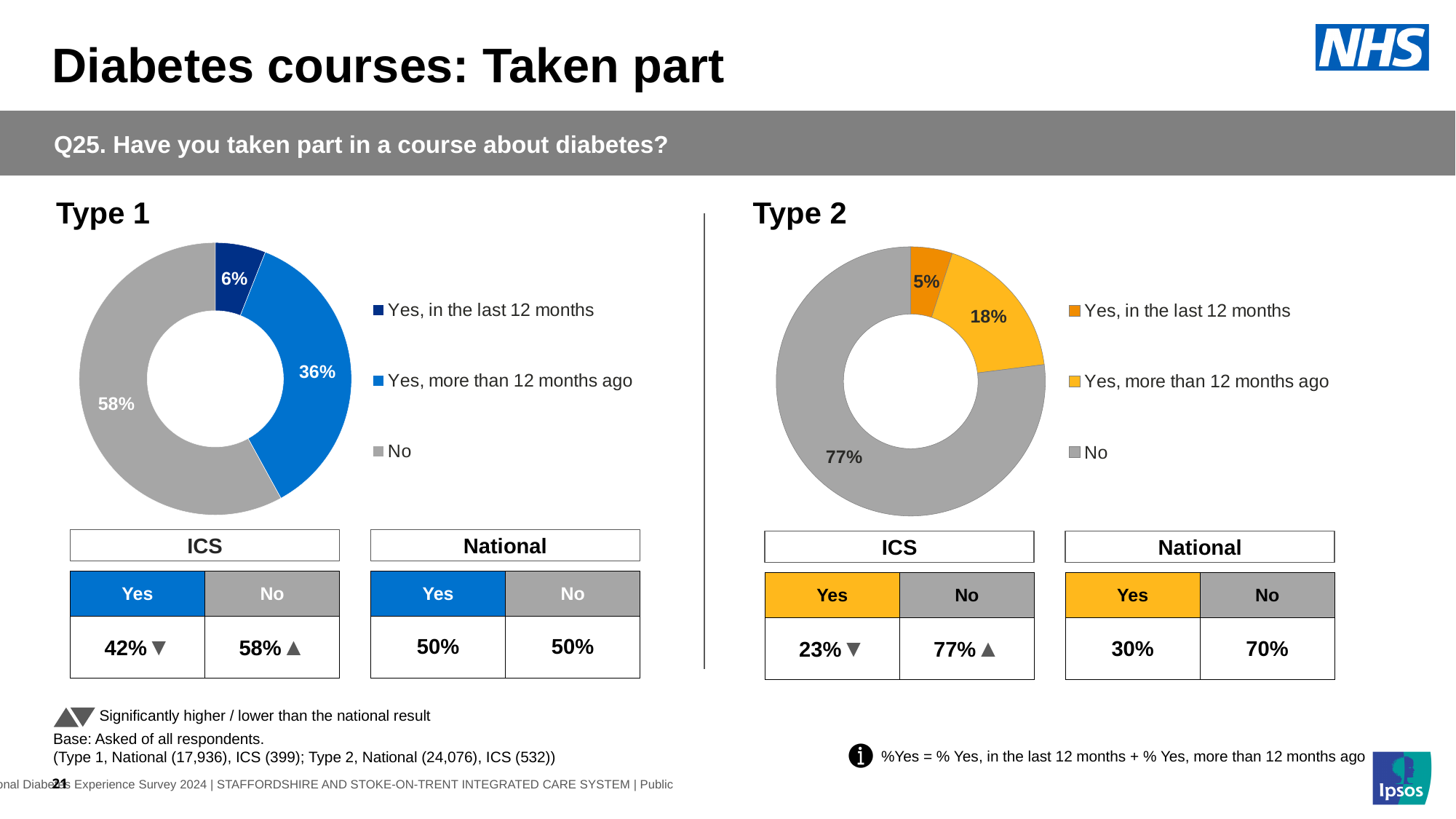
In the Type 2 chart, what percentage of respondents answered 'Yes, more than 12 months ago'? 18% In the Type 2 chart, what colour represents 'No'? Grey In the Type 1 chart, what percentage of respondents answered 'Yes, in the last 12 months'? 6% How many categories does the Type 1 chart show? 3 In the Type 2 chart, which response category has the largest share? No In the Type 1 chart, what is the combined share of the two 'Yes' categories? 42% What kind of chart is used for Type 2? Doughnut chart What is the title of the chart on the right side of the slide? Type 2 Which is larger: the 'Yes, more than 12 months ago' share in the Type 1 chart or in the Type 2 chart? Type 1 In the Type 1 chart, what percentage of respondents answered 'No'? 58% In the Type 1 chart, which response category has the smallest share? Yes, in the last 12 months In the Type 2 chart, what is the difference between the 'No' share and the 'Yes, more than 12 months ago' share? 59 percentage points